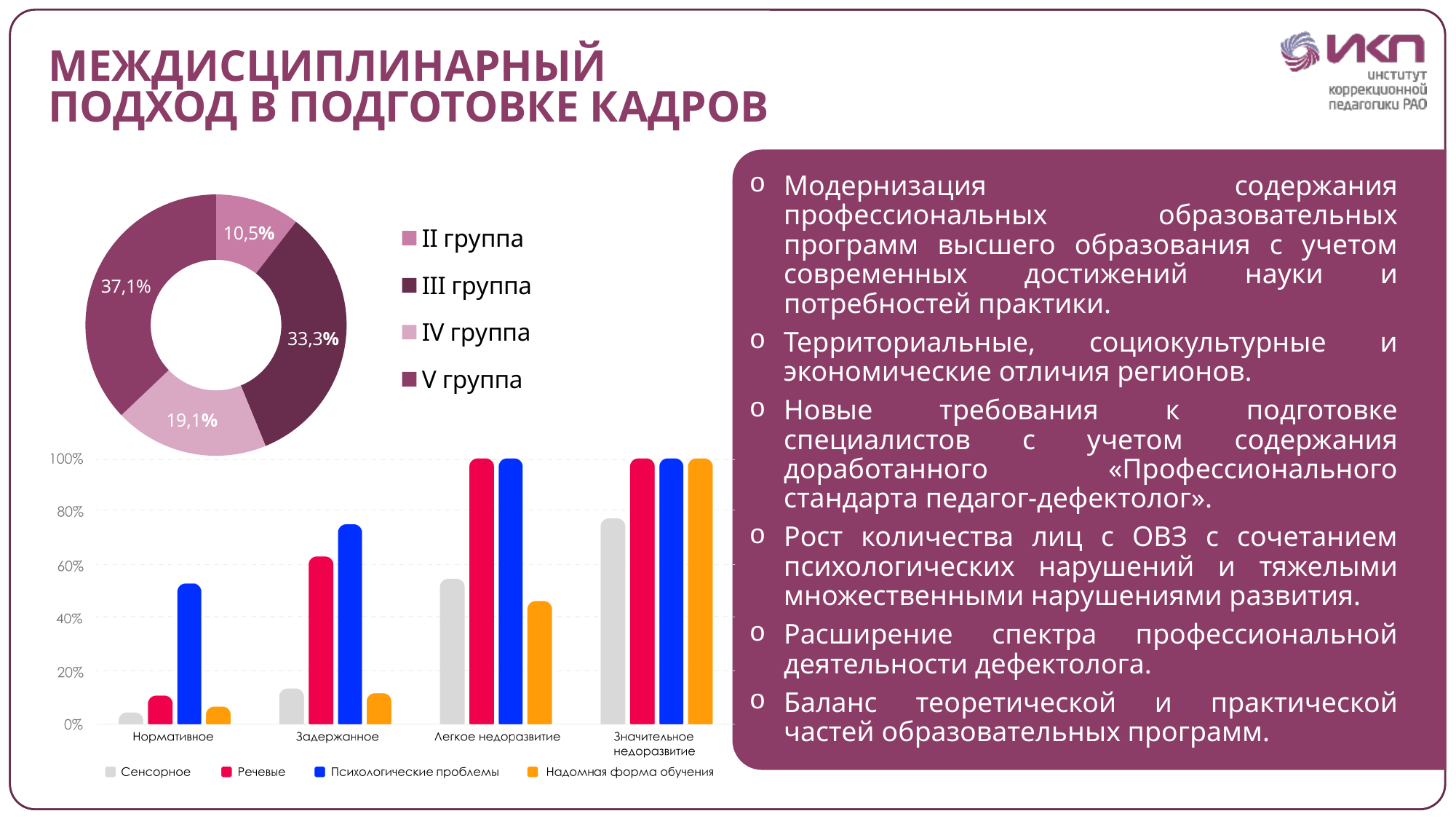
In the donut chart at the top left, which group has the smallest share? II группа In the bar chart at the bottom left, which is larger in the Задержанное category: Речевые or Психологические проблемы? Психологические проблемы In the bar chart at the bottom left, how many series does the legend list? 4 What kind of chart is the one at the bottom left of the slide? Bar chart In the donut chart at the top left, which group has the largest share? V группа In the donut chart at the top left, what share does IV группа have? 19,1% In the donut chart at the top left, what share does III группа have? 33,3% In the donut chart at the top left, how many groups are shown in the legend? 4 In the bar chart at the bottom left, how many categories are on the x axis? 4 What kind of chart is the one at the top left of the slide? Donut (pie) chart In the donut chart at the top left, what is the difference in percentage points between V группа and II группа? 26,6 In the bar chart at the bottom left, is the value for Психологические проблемы in the Нормативное category greater or less than 40%? greater